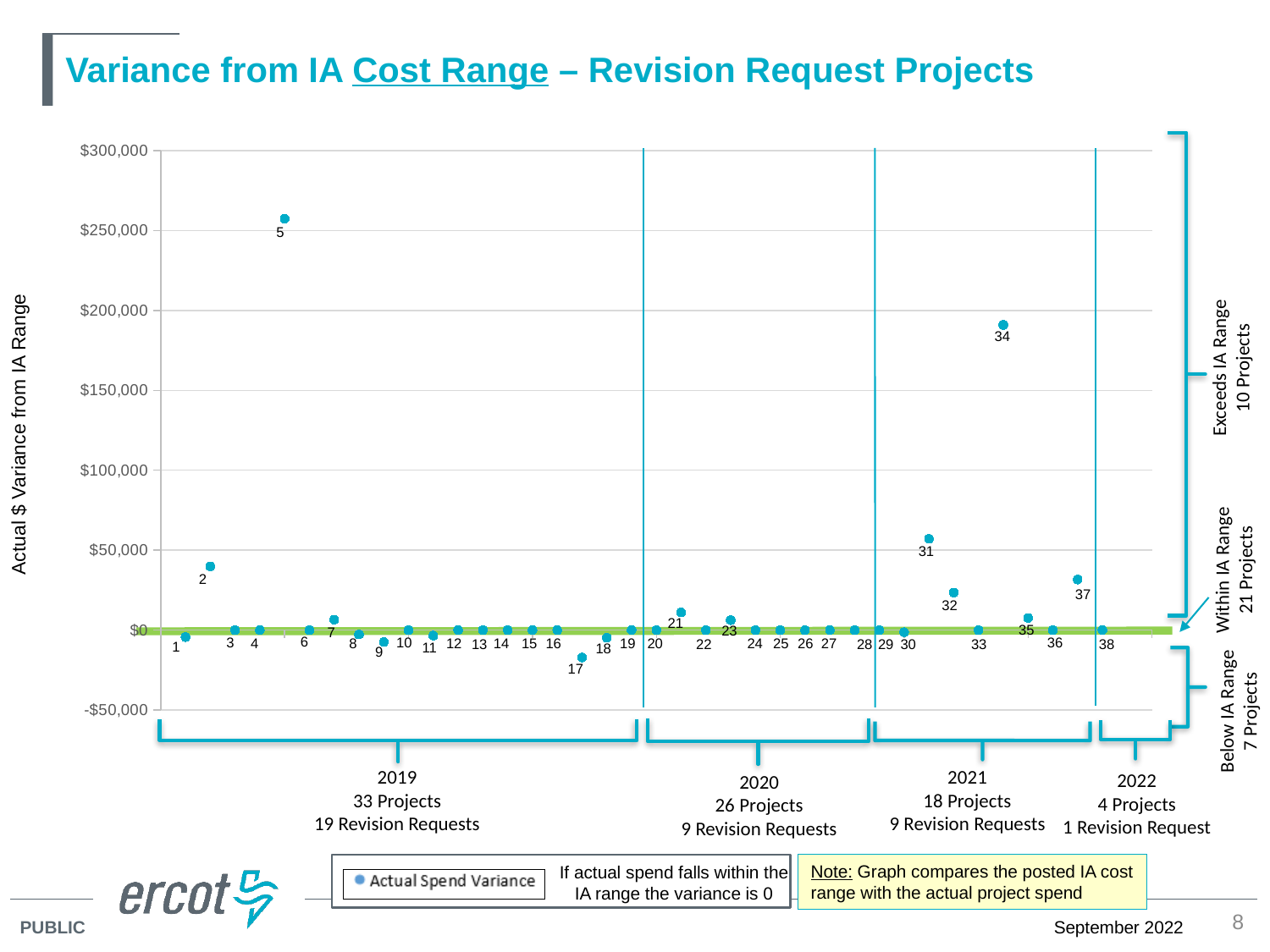
Is the value for project 34 greater or less than $200,000? less Which numbered project has the lowest actual $ variance from the IA range? 17 What kind of chart is shown on the slide? Scatter chart How many numbered project points are plotted on the chart? 38 Which numbered project has the highest actual $ variance from the IA range? 5 Is the value for project 17 greater or less than $0? less Is the value for project 2 greater or less than $50,000? less Which has the larger variance, project 5 or project 34? Project 5 How many series does the legend list? 1 Which has the larger variance, project 37 or project 35? Project 37